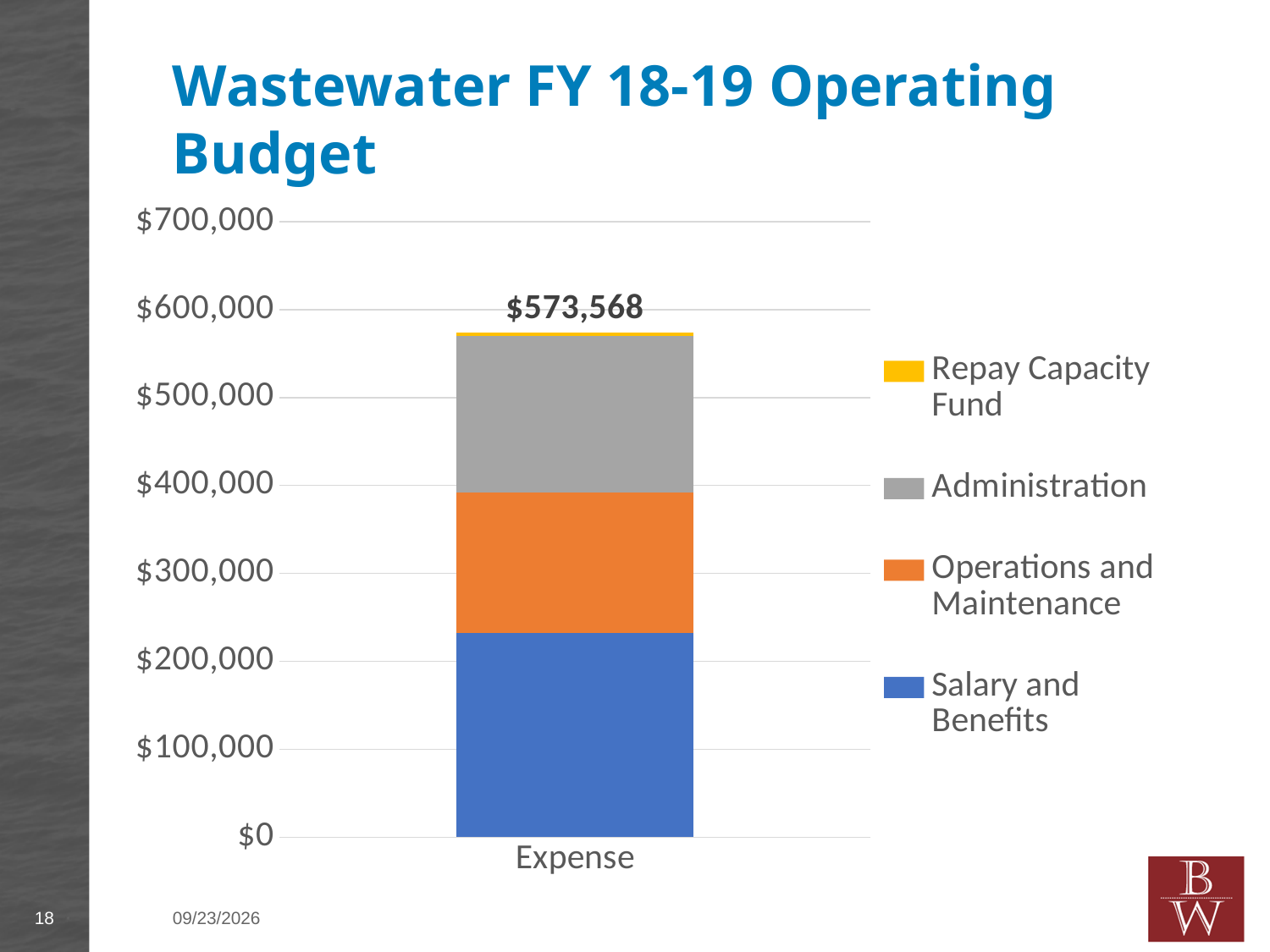
Which is larger in the Expense bar, Salary and Benefits or Operations and Maintenance? Salary and Benefits Which series is the largest segment of the Expense bar? Salary and Benefits Is the total of the Expense bar greater or less than $600,000? less How many categories are shown on the x axis? 1 What kind of chart is shown on the slide? Stacked bar chart Which series is the smallest segment of the Expense bar? Repay Capacity Fund Which series is shown in yellow in the legend? Repay Capacity Fund What is the total value labelled on the Expense bar? $573,568 Is the value for Salary and Benefits greater or less than $200,000? greater What is the label of the category on the x axis? Expense Is the value for Salary and Benefits greater or less than $300,000? less How many series does the legend list? 4